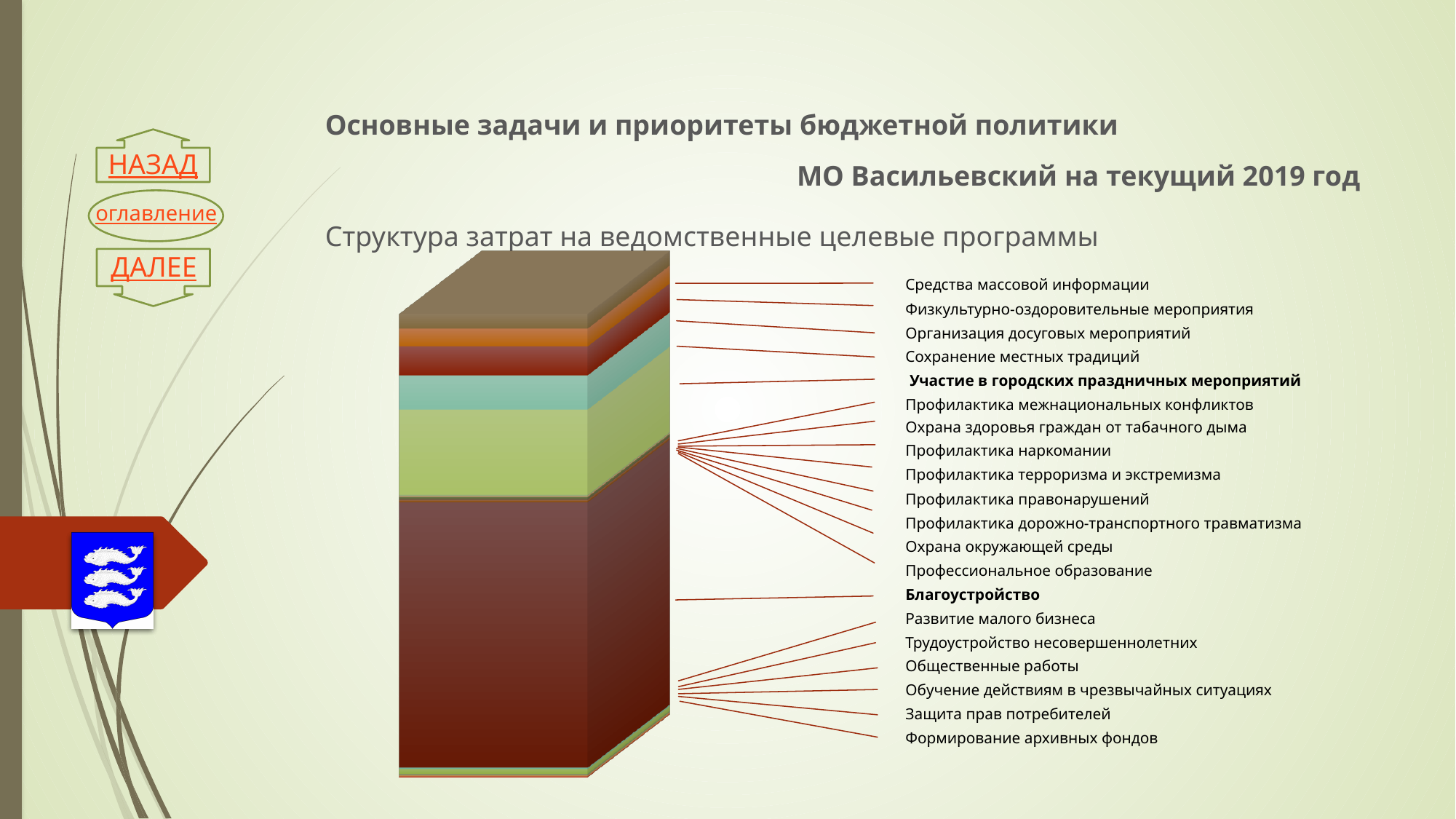
Which category occupies the largest segment of the stacked bar? Благоустройство Which segment is larger: Благоустройство or Участие в городских праздничных мероприятиях? Благоустройство Which segment is larger: Благоустройство or Средства массовой информации? Благоустройство How many categories (programme labels) are listed next to the stacked bar? 20 How many bars does the chart contain? 1 Which segment is larger: Участие в городских праздничных мероприятиях or Сохранение местных традиций? Участие в городских праздничных мероприятиях What is the title of the chart? Структура затрат на ведомственные целевые программы What kind of chart is shown on the slide? Stacked bar chart Which two category labels are printed in bold? Участие в городских праздничных мероприятиях and Благоустройство